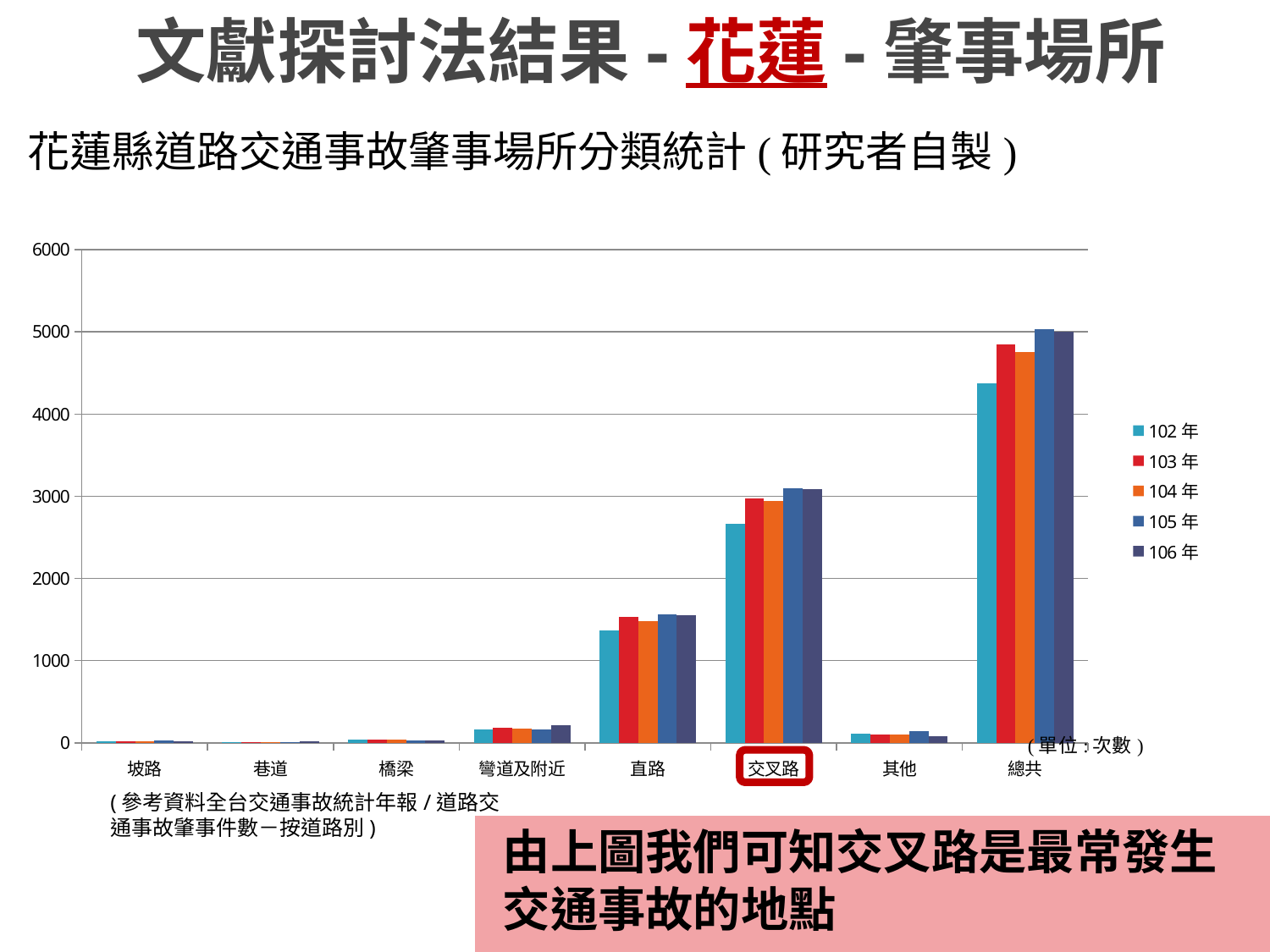
How many categories are shown along the x axis of the chart? 8 What is the first series listed in the chart's legend? 102 年 Is the value for 總共 in 102 年 greater or less than 5000? less How many series does the chart's legend list? 5 Which category has the tallest bars in the chart? 總共 What kind of chart is shown on the slide? bar chart For 106 年, which is larger: the value for 坡路 or the value for 彎道及附近? 彎道及附近 Is the value for 交叉路 in 102 年 greater or less than 2000? greater Is the value for 彎道及附近 in 106 年 greater or less than 1000? less For 103 年, which is larger: the value for 直路 or the value for 交叉路? 交叉路 Excluding 總共, which location category has the tallest bars? 交叉路